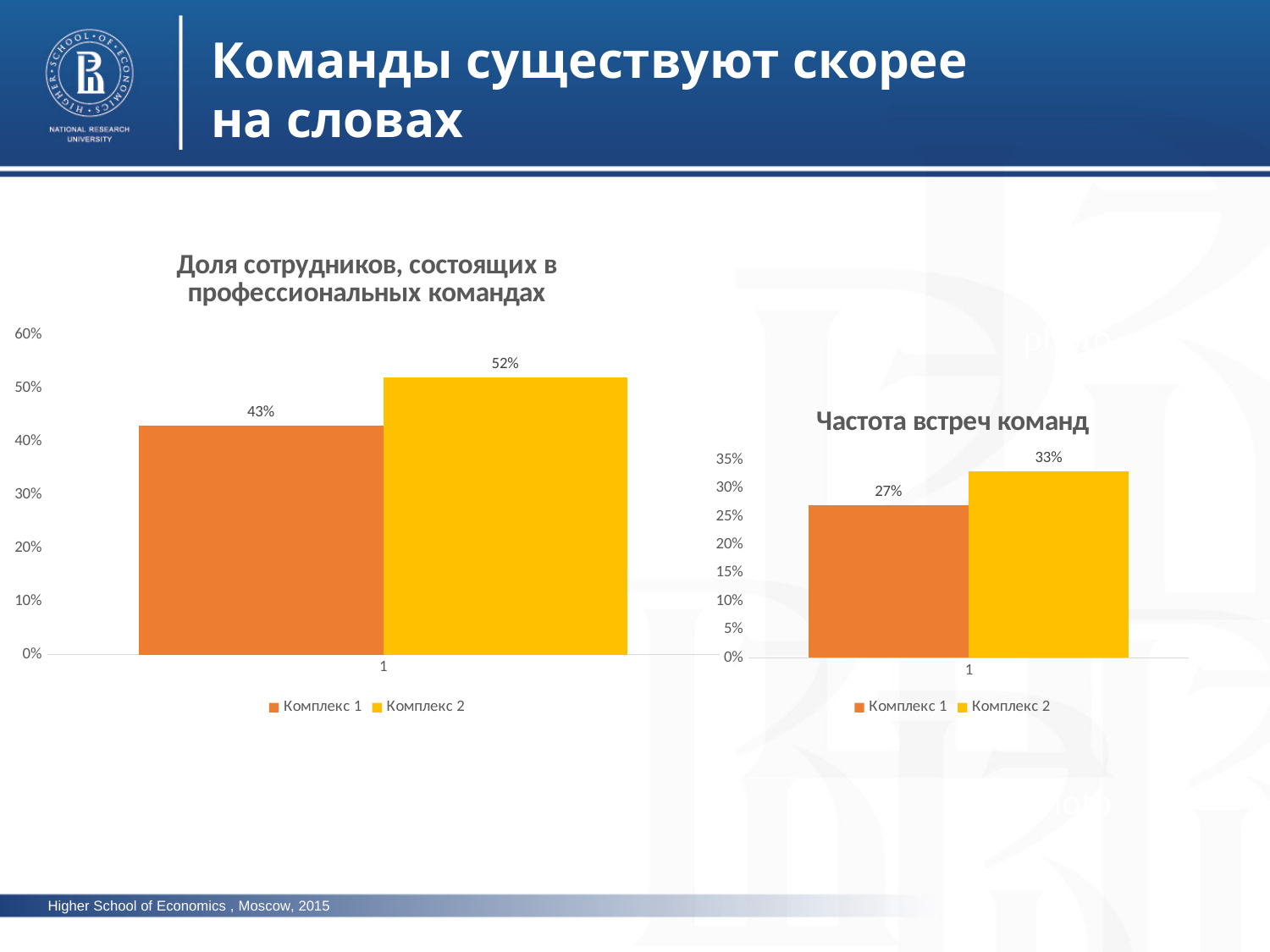
In the chart 'Доля сотрудников, состоящих в профессиональных командах', what is the difference between Комплекс 2 and Комплекс 1? 9% In the chart 'Доля сотрудников, состоящих в профессиональных командах', what is the value for Комплекс 2? 52% In the chart 'Частота встреч команд', what is the value for Комплекс 1? 27% In the chart 'Частота встреч команд', what is the value for Комплекс 2? 33% What kind of chart is 'Доля сотрудников, состоящих в профессиональных командах'? bar chart In the chart 'Доля сотрудников, состоящих в профессиональных командах', what colour is the bar for Комплекс 2? yellow How many series does the legend of the chart 'Частота встреч команд' list? 2 In the chart 'Доля сотрудников, состоящих в профессиональных командах', which series has the higher value? Комплекс 2 In the chart 'Частота встреч команд', which series has the lower value? Комплекс 1 In the chart 'Доля сотрудников, состоящих в профессиональных командах', what is the value for Комплекс 1? 43% In the chart 'Частота встреч команд', what is the difference between Комплекс 2 and Комплекс 1? 6% In the chart 'Частота встреч команд', is the value for Комплекс 1 greater or less than 30%? less